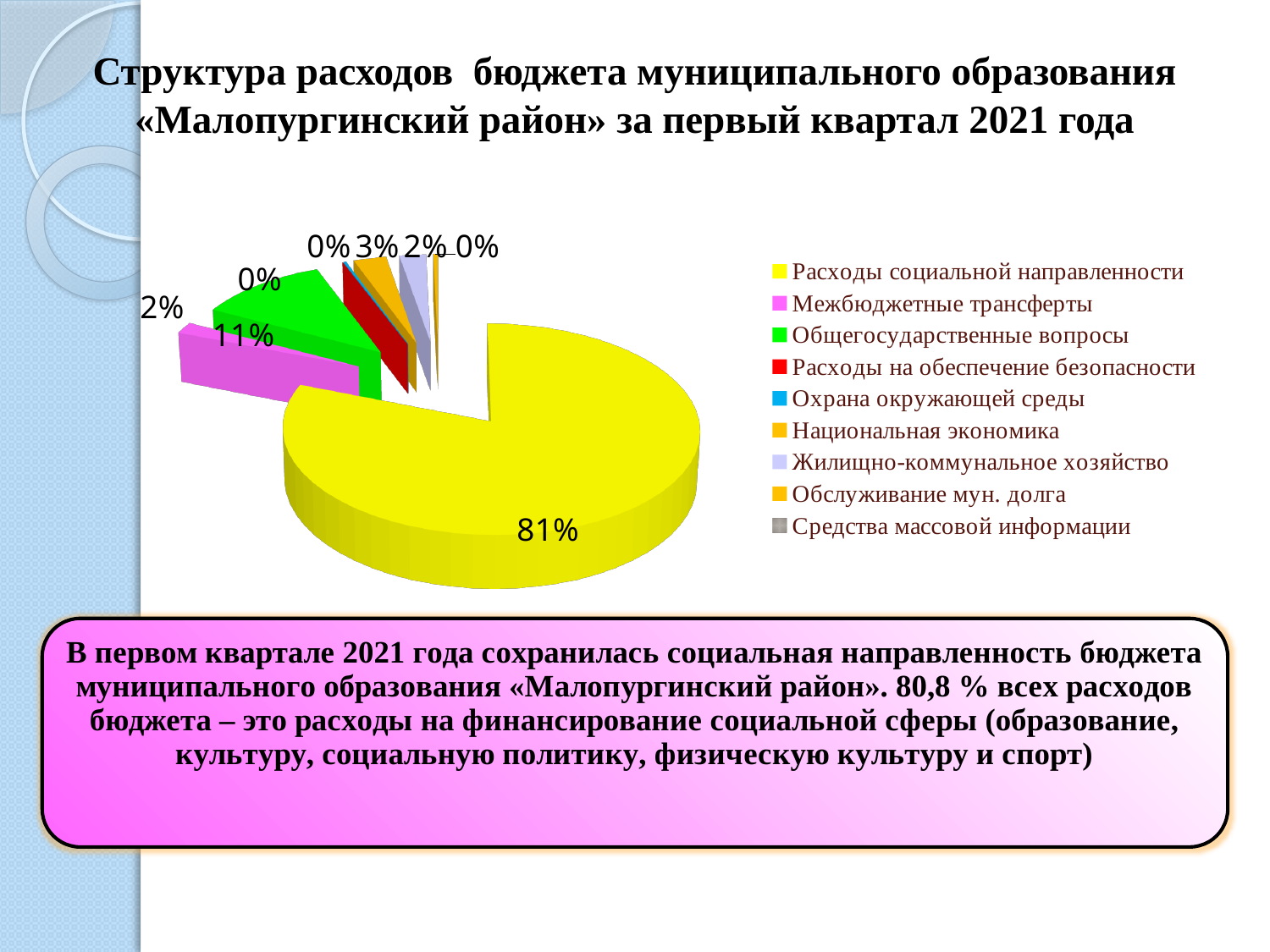
How many slices (categories) does the pie chart represent according to the legend? 9 What colour represents Расходы социальной направленности in the chart? yellow What kind of chart is shown on the slide? pie chart Which is larger: the share for Расходы социальной направленности or for Межбюджетные трансферты? Расходы социальной направленности Which period does the chart title say the expense structure covers? первый квартал 2021 года What share of expenses is shown for Межбюджетные трансферты? 2% What share of expenses is shown for Расходы социальной направленности? 81% By how many percentage points does the share for Расходы социальной направленности exceed the share for Межбюджетные трансферты? 79 percentage points Is the share for Расходы социальной направленности greater or less than 50%? greater How many categories does the legend list? 9 Which category has the largest share of the pie? Расходы социальной направленности